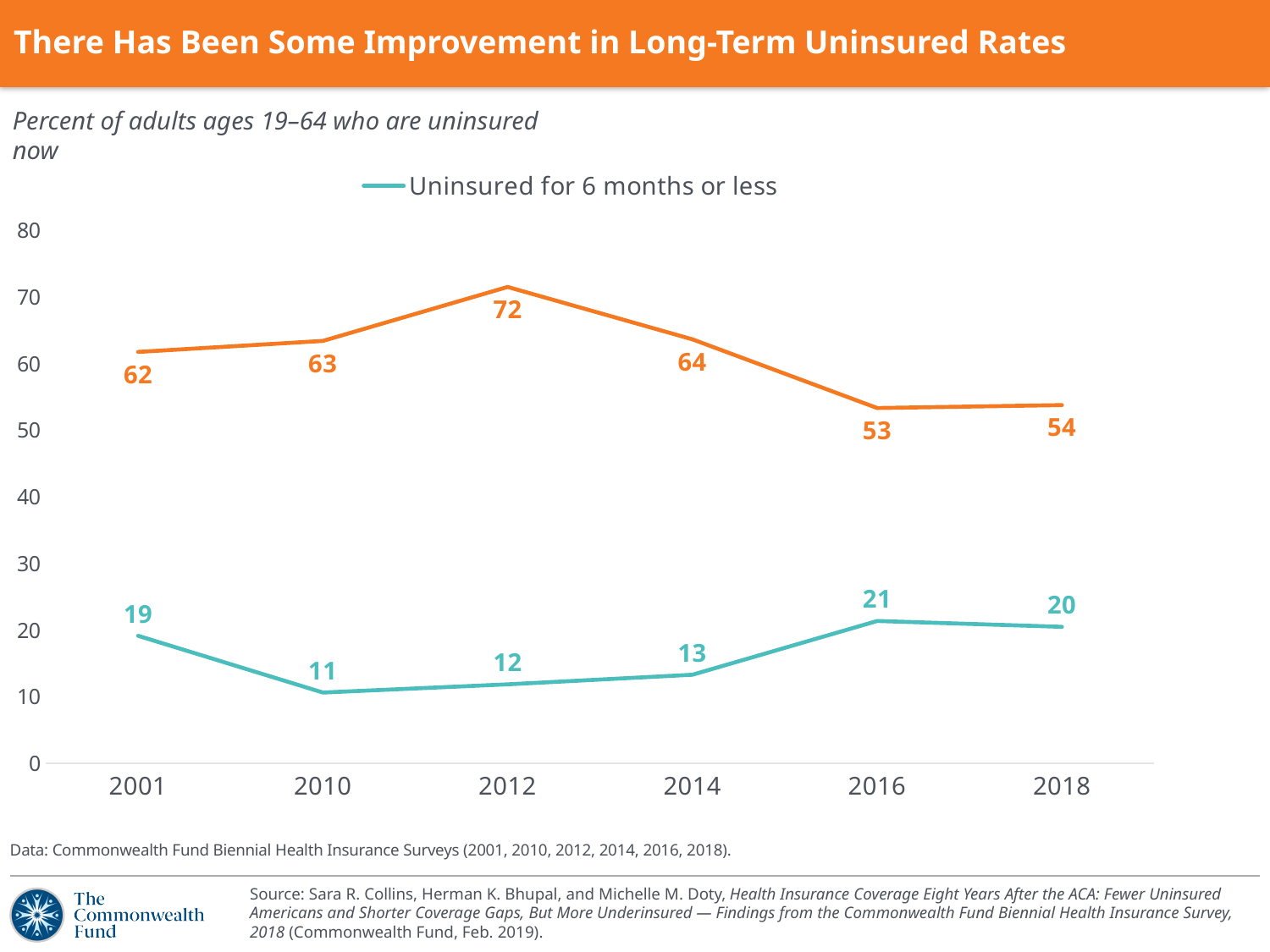
In which year is the 'Uninsured for 6 months or less' value lowest? 2010 In which year is the 'Uninsured for 6 months or less' value highest? 2016 What is the value for 'Uninsured for 6 months or less' in 2016? 21 How many series does the legend list? 1 Which is larger for 'Uninsured for 6 months or less': the value in 2018 or the value in 2014? 2018 In which year does the orange line reach its highest value? 2012 What is the value for 'Uninsured for 6 months or less' in 2001? 19 Does the 'Uninsured for 6 months or less' line rise or fall from 2010 to 2016? rise How many years are shown on the x axis? 6 What is the title of the slide? There Has Been Some Improvement in Long-Term Uninsured Rates What kind of chart is shown on the slide? line chart What is the difference between the 'Uninsured for 6 months or less' values in 2016 and 2010? 10